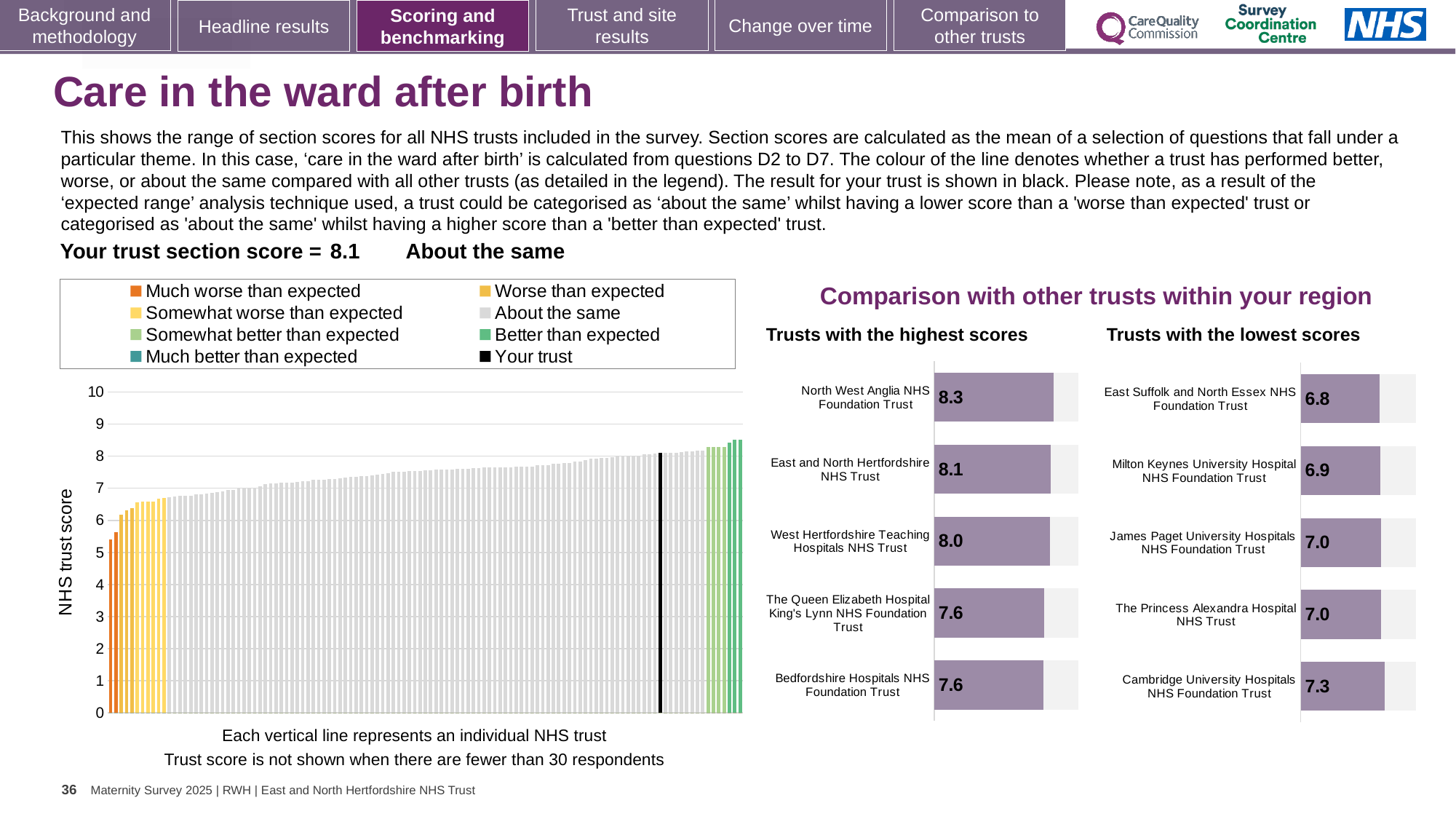
In the large chart on the left, do the bar values rise or fall from left to right along the x axis? Rise In the 'Trusts with the highest scores' chart, what is the score for North West Anglia NHS Foundation Trust? 8.3 In the 'Trusts with the lowest scores' chart, which has the higher score: Milton Keynes University Hospital NHS Foundation Trust or Cambridge University Hospitals NHS Foundation Trust? Cambridge University Hospitals NHS Foundation Trust What type of chart is the large chart on the left showing NHS trust scores? Bar chart In the 'Trusts with the highest scores' chart, what is the difference between the scores of North West Anglia NHS Foundation Trust and Bedfordshire Hospitals NHS Foundation Trust? 0.7 In the 'Trusts with the lowest scores' chart, what is the score for Cambridge University Hospitals NHS Foundation Trust? 7.3 In the 'Trusts with the highest scores' chart, which trust has the highest score? North West Anglia NHS Foundation Trust In the 'Trusts with the lowest scores' chart, which trust has the lowest score? East Suffolk and North Essex NHS Foundation Trust In the 'Trusts with the highest scores' chart, what is the score for West Hertfordshire Teaching Hospitals NHS Trust? 8.0 How many trusts are listed in the 'Trusts with the highest scores' chart? 5 How many entries does the legend of the large chart on the left list? 8 In the 'Trusts with the lowest scores' chart, what is the difference between the scores of Cambridge University Hospitals NHS Foundation Trust and East Suffolk and North Essex NHS Foundation Trust? 0.5